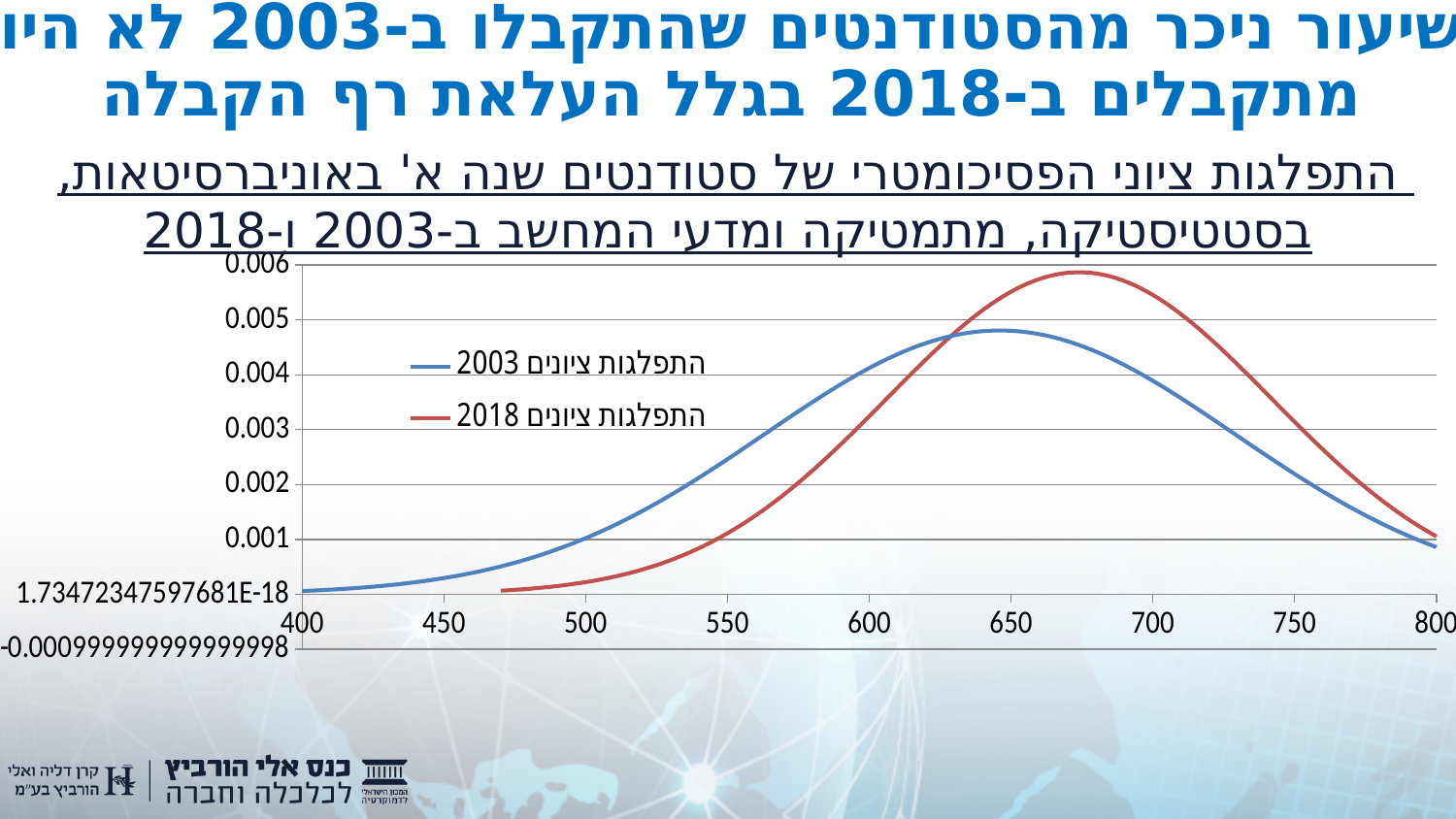
How many series does the legend list? 2 Is the peak value of the התפלגות ציונים 2018 series greater or less than 0.005? greater Is the peak value of the התפלגות ציונים 2003 series greater or less than 0.005? less Does the התפלגות ציונים 2003 series rise or fall between x = 400 and x = 600? rise Which colour is used for the series התפלגות ציונים 2018? red At x = 700, which series has the higher value, התפלגות ציונים 2003 or התפלגות ציונים 2018? התפלגות ציונים 2018 What kind of chart is shown on the slide? line chart Which series reaches the higher peak value, התפלגות ציונים 2003 or התפלגות ציונים 2018? התפלגות ציונים 2018 Is the value of the התפלגות ציונים 2018 series at 500 greater or less than 0.001? less Which colour is used for the series התפלגות ציונים 2003? blue At x = 550, which series has the higher value, התפלגות ציונים 2003 or התפלגות ציונים 2018? התפלגות ציונים 2003